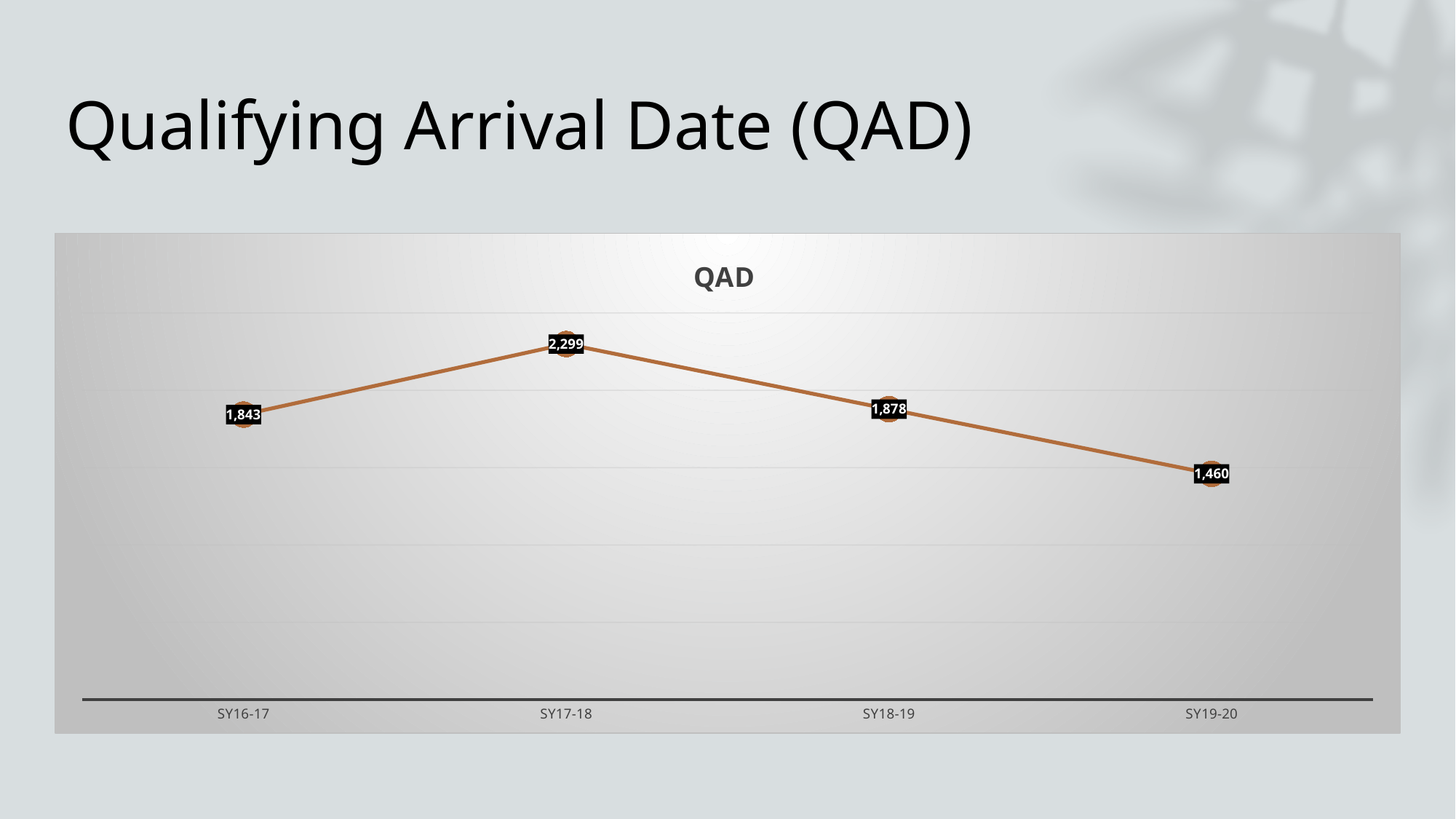
What is the difference between the QAD values for SY18-19 and SY16-17? 35 How many school years are plotted on the chart? 4 Which is larger, the QAD value for SY16-17 or for SY19-20? SY16-17 What is the QAD value for SY19-20? 1,460 What kind of chart is shown on the slide? Line chart What is the difference between the QAD values for SY17-18 and SY19-20? 839 Which school year has the highest QAD value? SY17-18 Which school year has the lowest QAD value? SY19-20 What is the QAD value for SY16-17? 1,843 What is the QAD value for SY18-19? 1,878 What is the QAD value for SY17-18? 2,299 What is the title of the chart? QAD